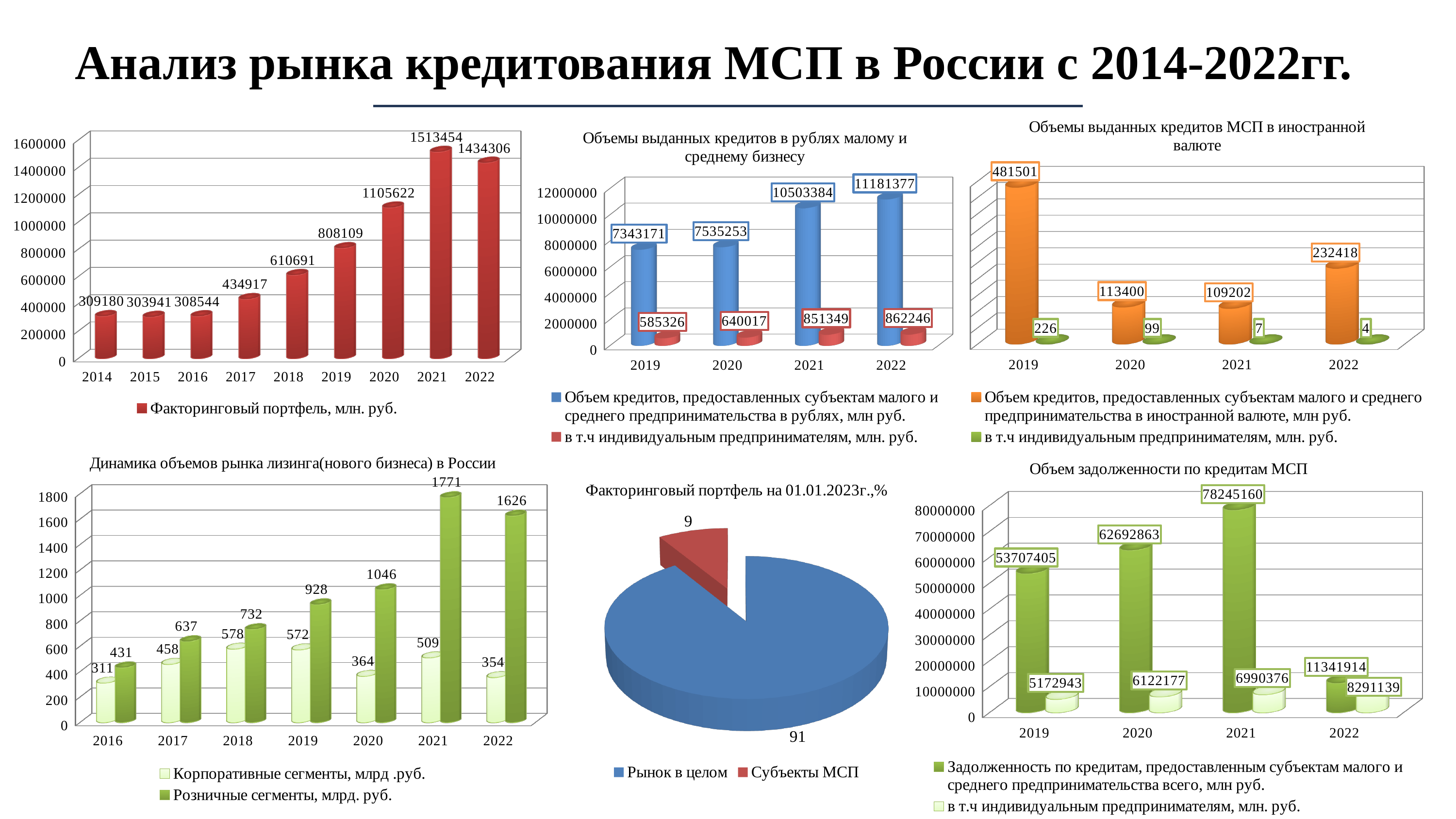
In the chart 'Объемы выданных кредитов МСП в иностранной валюте', which year has the highest value for the orange series? 2019 In the chart 'Динамика объемов рынка лизинга(нового бизнеса) в России', which is larger in 2019: Корпоративные сегменты or Розничные сегменты? Розничные сегменты In the pie chart 'Факторинговый портфель на 01.01.2023г.,%', what share does Субъекты МСП have? 9 In the chart 'Объем задолженности по кредитам МСП', what is the value of the light green series (в т.ч индивидуальным предпринимателям) for 2020? 6122177 In the chart 'Объемы выданных кредитов МСП в иностранной валюте', what is the green series value for 2022? 4 In the chart 'Объемы выданных кредитов в рублях малому и среднему бизнесу', what is the value of the blue series for 2022? 11181377 In the top-left chart (Факторинговый портфель, млн. руб.), what is the value for 2021? 1513454 In the chart 'Динамика объемов рынка лизинга(нового бизнеса) в России', what is the value of Розничные сегменты for 2021? 1771 In the chart 'Объемы выданных кредитов в рублях малому и среднему бизнесу', what is the difference between the red series values for 2022 and 2021? 10897 In the top-left chart (Факторинговый портфель, млн. руб.), which year has the lowest value? 2015 In the top-left chart (Факторинговый портфель, млн. руб.), how many years are shown on the x axis? 9 What type of chart is 'Факторинговый портфель на 01.01.2023г.,%'? pie chart